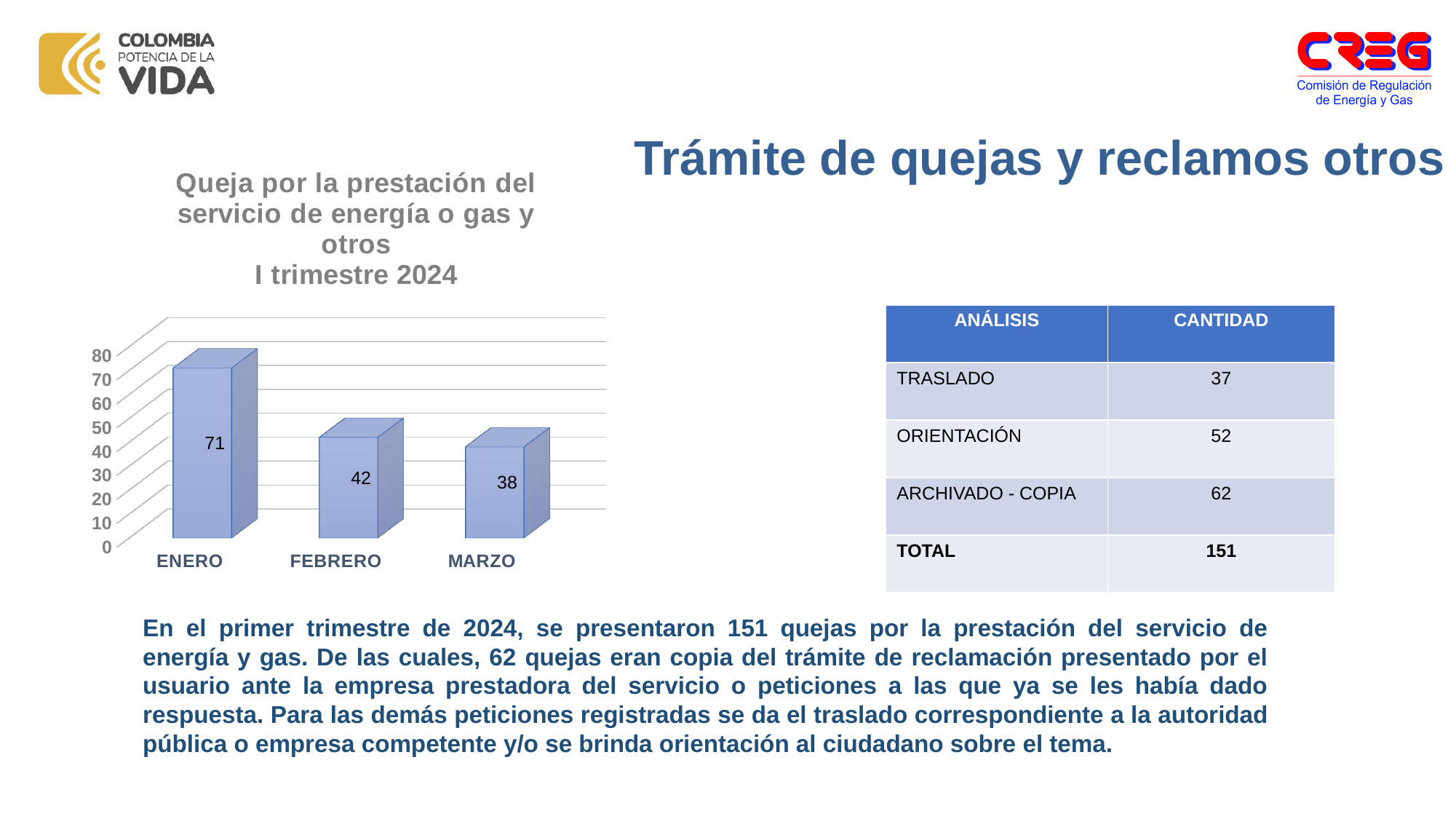
What is the value for MARZO in the chart? 38 What is the value for FEBRERO in the chart? 42 Which month has the highest value in the chart? ENERO Which month has the lowest value in the chart? MARZO What is the value for ENERO in the chart? 71 Do the values rise or fall from ENERO to MARZO? fall How many months are shown on the x axis of the chart? 3 What kind of chart is shown on the slide? bar chart What is the difference between the values for FEBRERO and MARZO? 4 What is the difference between the values for ENERO and FEBRERO? 29 Which is larger, the value for ENERO or the value for MARZO? ENERO Is the value for ENERO greater or less than 60? greater